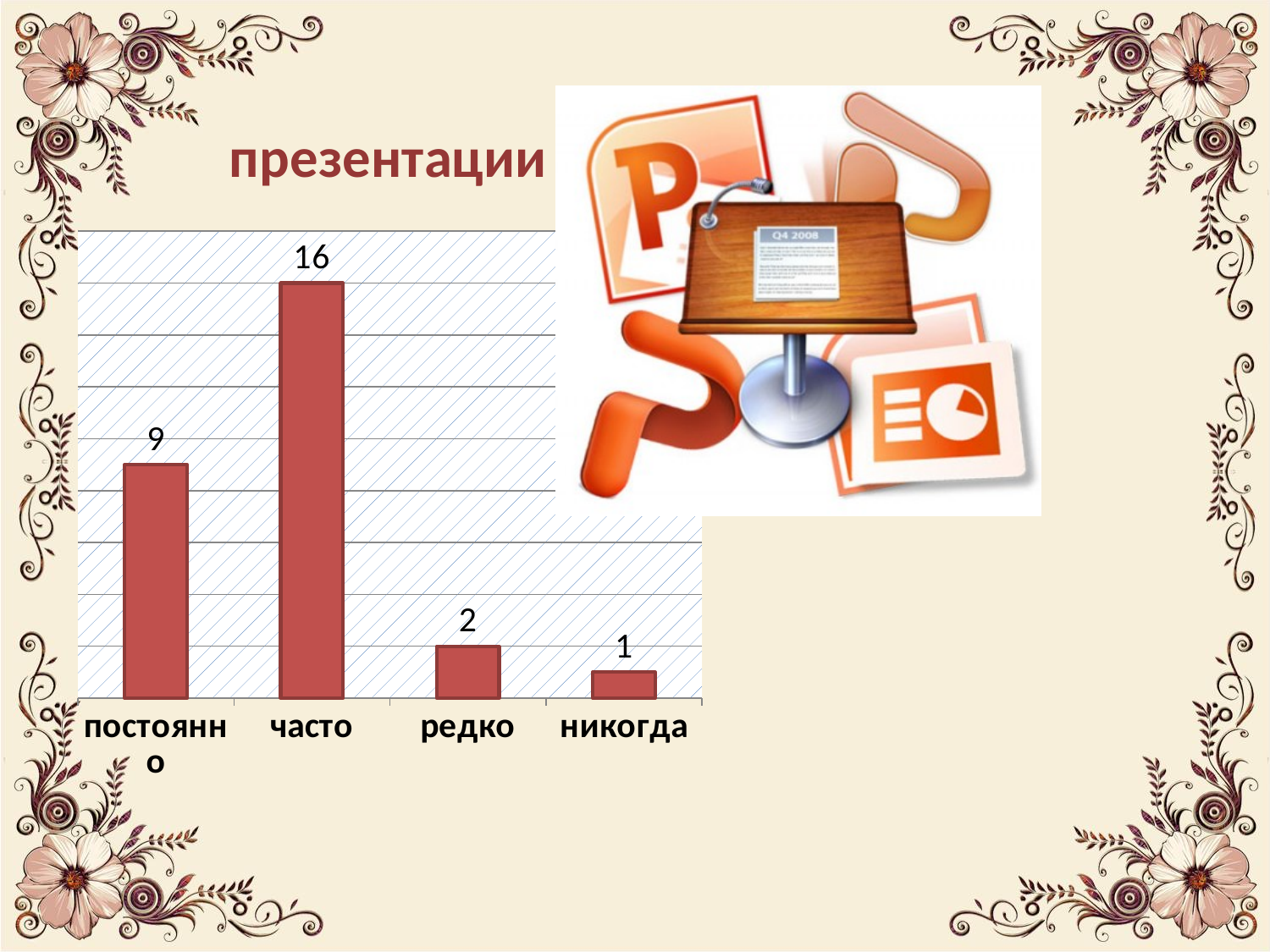
What is the total of all four bars? 28 How many categories are shown on the chart? 4 What is the title shown above the chart? презентации What is the value for "часто"? 16 Which is larger, the value for "редко" or the value for "никогда"? редко What kind of chart is shown on the slide? bar chart Which category has the lowest value? никогда What is the difference between the values for "часто" and "постоянно"? 7 What is the value for "никогда"? 1 What is the value for "редко"? 2 What is the value for "постоянно"? 9 Which category has the highest value? часто